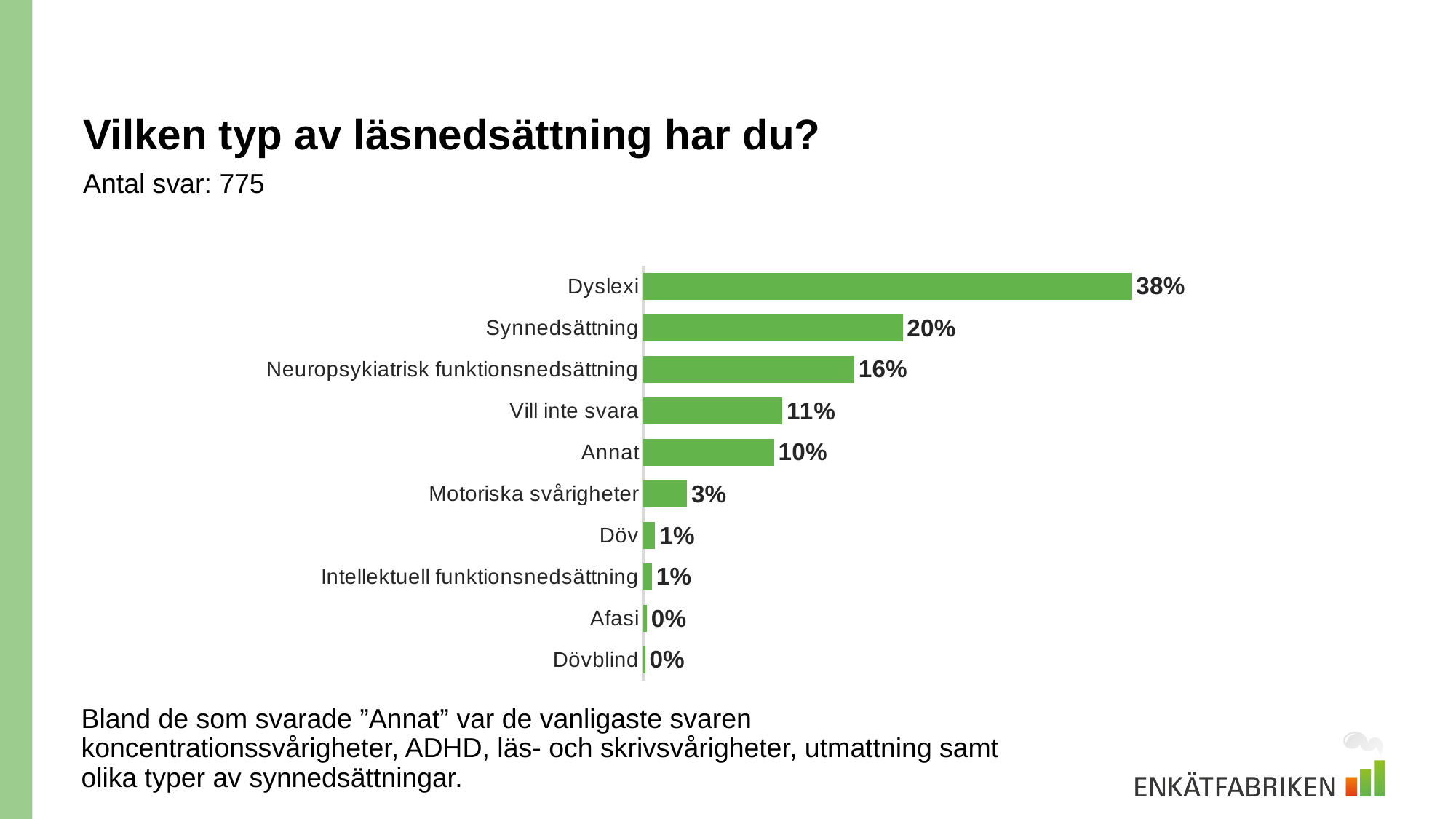
What is the value for Dyslexi? 38% What is the difference between the values for Vill inte svara and Annat? 1% What is the value for Neuropsykiatrisk funktionsnedsättning? 16% How many categories are shown in the chart? 10 Which category has the highest value? Dyslexi What is the title of the chart? Vilken typ av läsnedsättning har du? How many responses (Antal svar) does the slide report? 775 Which is larger, the value for Synnedsättning or the value for Neuropsykiatrisk funktionsnedsättning? Synnedsättning What kind of chart is shown on the slide? Bar chart What is the difference between the values for Dyslexi and Synnedsättning? 18% What is the value for Synnedsättning? 20% What is the value for Motoriska svårigheter? 3%